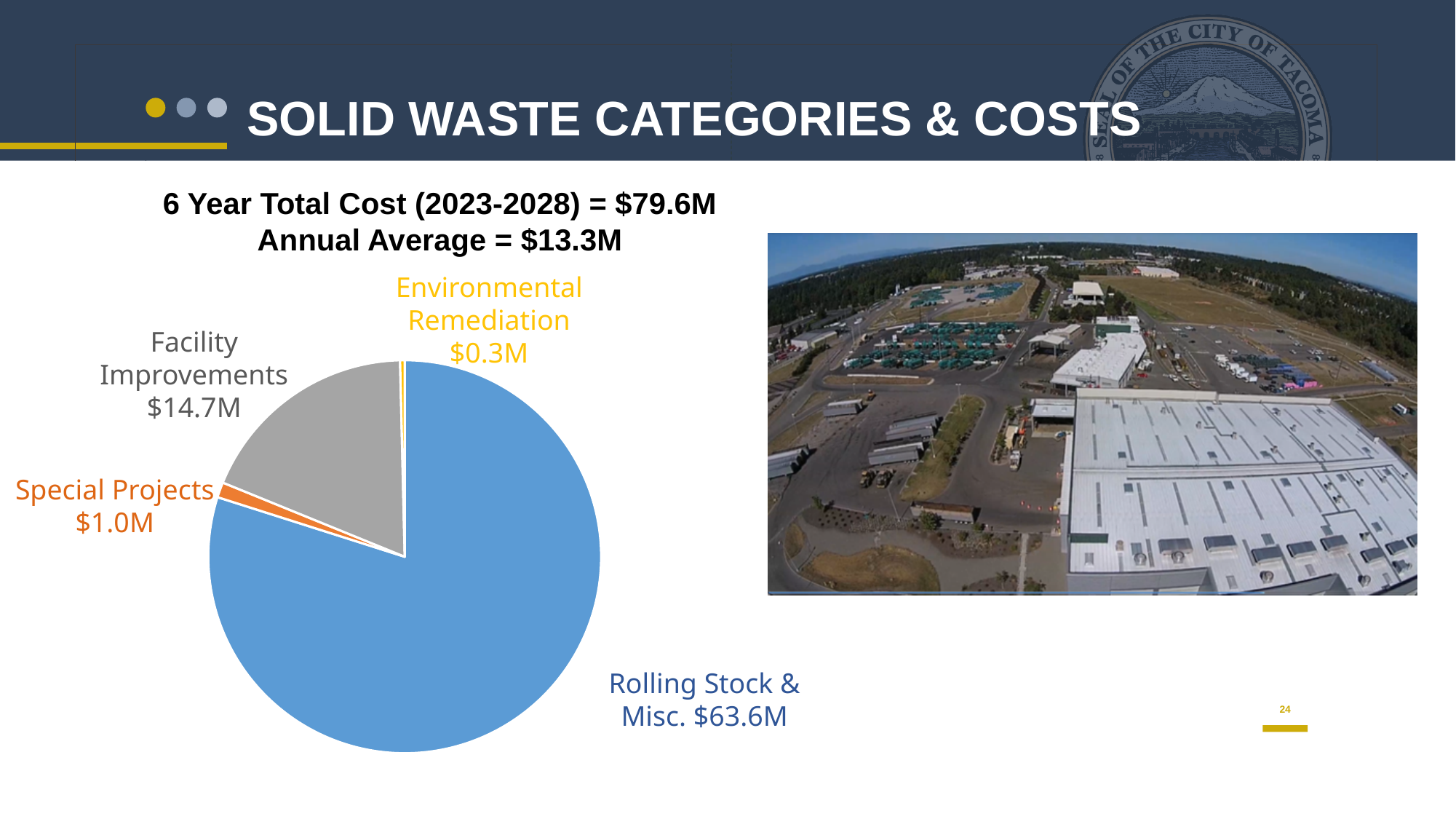
What is the cost shown for Environmental Remediation in the pie chart? $0.3M What is the cost shown for Special Projects in the pie chart? $1.0M What is the difference between the Facility Improvements cost and the Special Projects cost? $13.7M What is the cost shown for Rolling Stock & Misc. in the pie chart? $63.6M What is the 6 year total cost (2023-2028) stated above the pie chart? $79.6M What kind of chart is used to show the solid waste categories and costs? Pie chart How many categories are shown in the pie chart? 4 Which is larger, the cost for Special Projects or the cost for Environmental Remediation? Special Projects What is the cost shown for Facility Improvements in the pie chart? $14.7M What is the difference between the Rolling Stock & Misc. cost and the Facility Improvements cost? $48.9M Which category has the largest slice of the pie chart? Rolling Stock & Misc. Which category has the smallest slice of the pie chart? Environmental Remediation